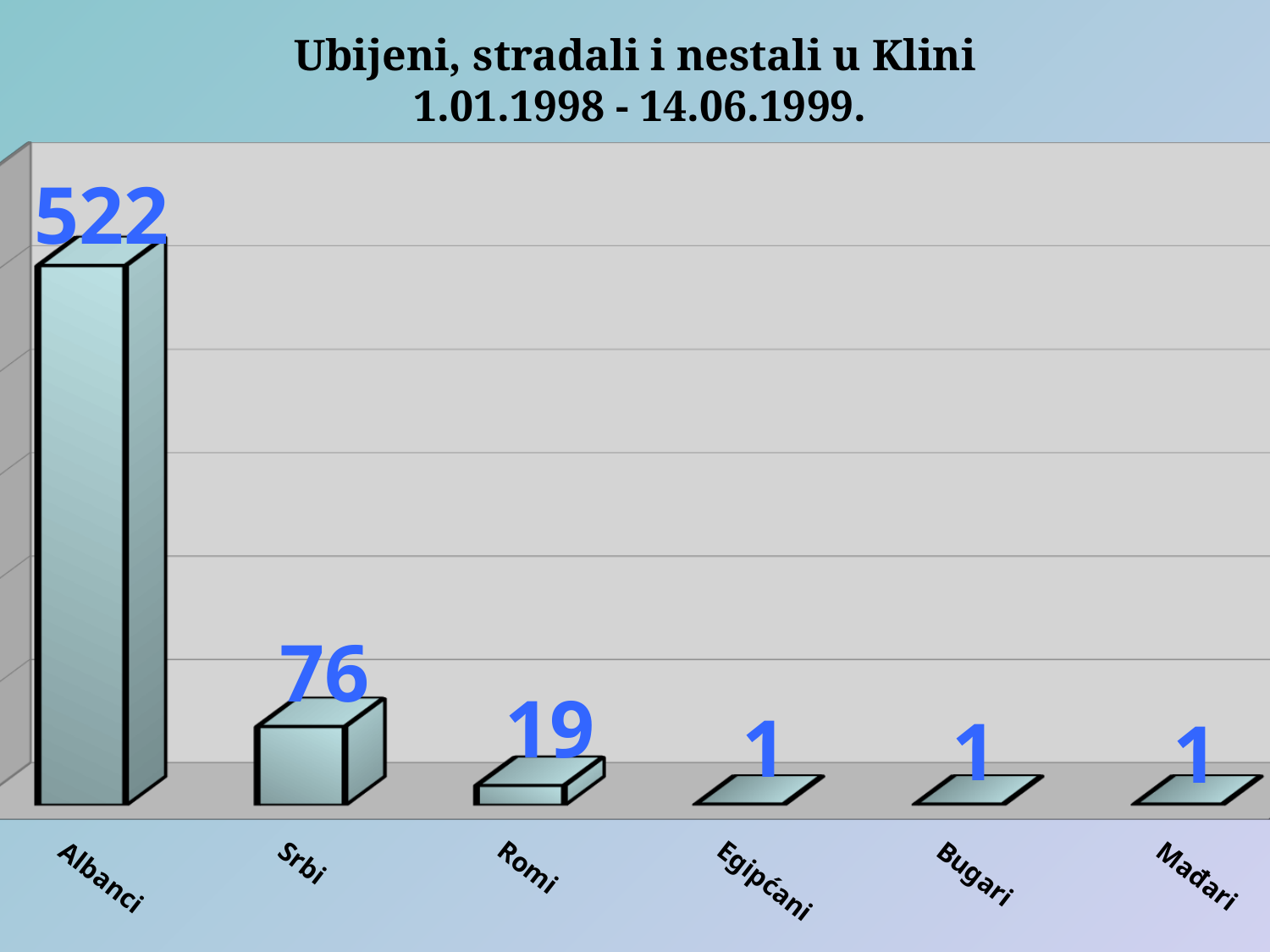
What is the value for Romi? 19 What is the difference between the values for Srbi and Romi? 57 What is the value for Egipćani? 1 What is the value for Albanci? 522 How many categories have a value of 1? 3 Which category has the highest value? Albanci What is the value for Srbi? 76 What is the title of the chart? Ubijeni, stradali i nestali u Klini 1.01.1998 - 14.06.1999. How many categories are shown on the x axis? 6 What kind of chart is shown on the slide? bar chart What is the difference between the values for Albanci and Srbi? 446 Which is larger, the value for Srbi or the value for Romi? Srbi